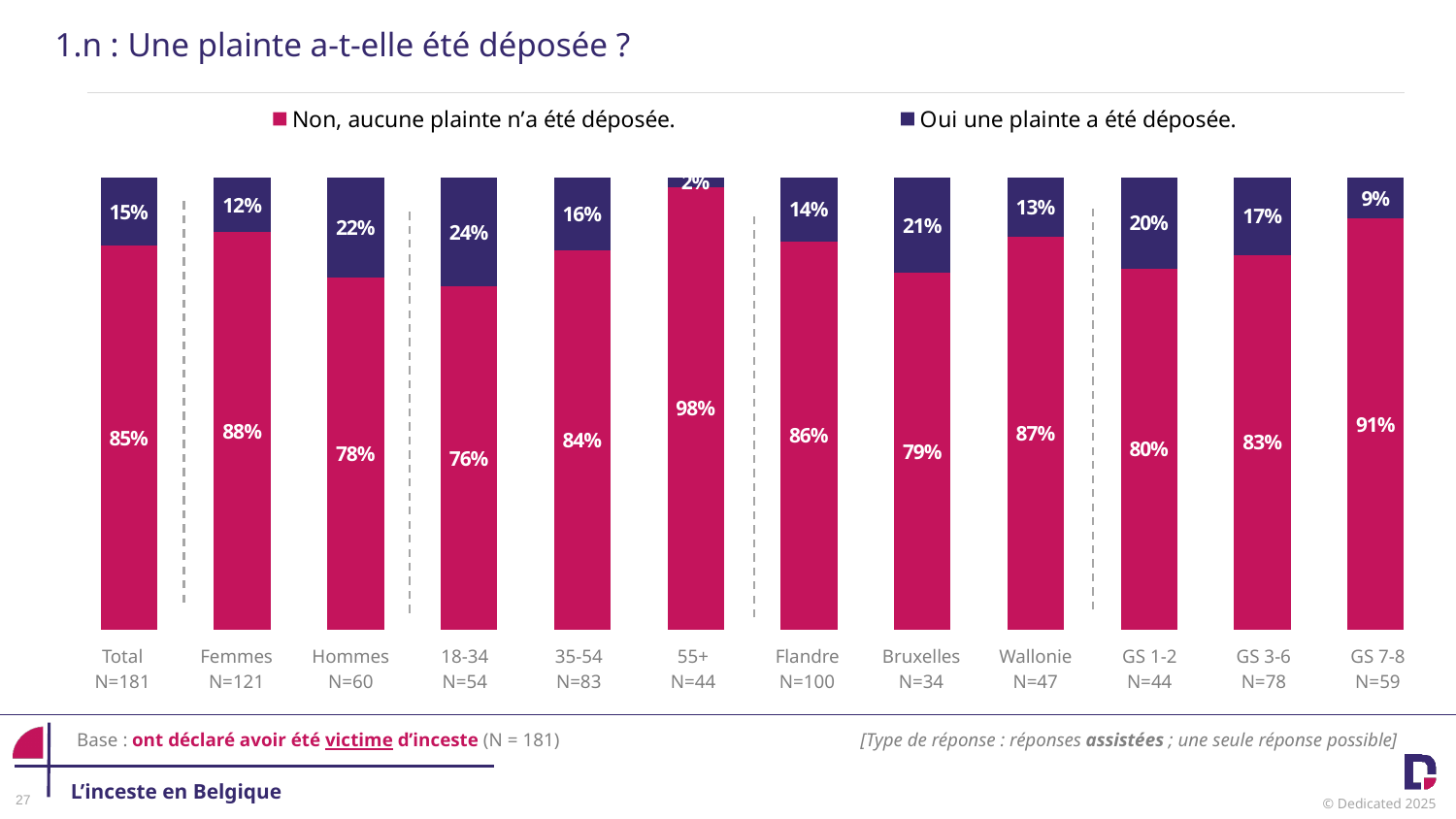
What is the difference between the 'Non, aucune plainte n'a été déposée' values for Femmes and Hommes? 10% How many categories are shown on the x axis of the chart? 12 What share of the 'Total' group said a complaint was filed ('Oui une plainte a été déposée')? 15% Which has a larger 'Oui une plainte a été déposée' value, Bruxelles or Wallonie? Bruxelles How many series does the legend list? 2 What is the value for 'Oui une plainte a été déposée' in the 18-34 group? 24% Which category has the highest value for 'Oui une plainte a été déposée'? 18-34 Which category has the highest value for 'Non, aucune plainte n'a été déposée'? 55+ Which category has the lowest value for 'Oui une plainte a été déposée'? 55+ What kind of chart is shown on the slide? Stacked bar chart What percentage of the 'Hommes' group answered 'Non, aucune plainte n'a été déposée'? 78% What is the sample size (N) shown for the Flandre category? N=100